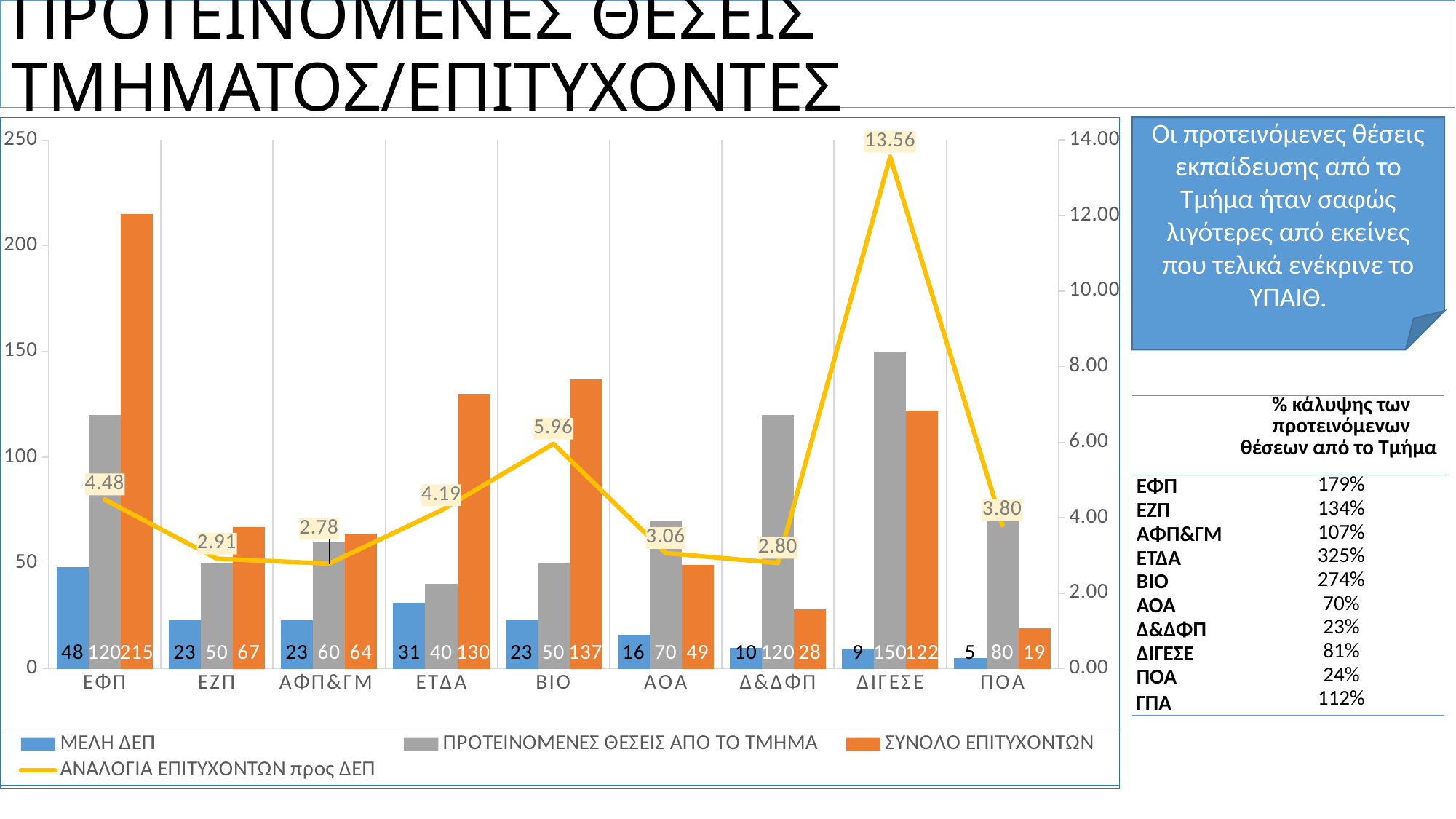
What is the value of ΑΝΑΛΟΓΙΑ ΕΠΙΤΥΧΟΝΤΩΝ προς ΔΕΠ for ΒΙΟ? 5.96 What is the value of ΜΕΛΗ ΔΕΠ for ΕΤΔΑ? 31 What is the value of ΠΡΟΤΕΙΝΟΜΕΝΕΣ ΘΕΣΕΙΣ ΑΠΟ ΤΟ ΤΜΗΜΑ for ΔΙΓΕΣΕ? 150 Which category has the highest value for ΑΝΑΛΟΓΙΑ ΕΠΙΤΥΧΟΝΤΩΝ προς ΔΕΠ? ΔΙΓΕΣΕ What is the difference between ΣΥΝΟΛΟ ΕΠΙΤΥΧΟΝΤΩΝ and ΠΡΟΤΕΙΝΟΜΕΝΕΣ ΘΕΣΕΙΣ ΑΠΟ ΤΟ ΤΜΗΜΑ for ΕΤΔΑ? 90 How many categories are shown on the x axis of the chart? 9 Which category has the lowest value for ΜΕΛΗ ΔΕΠ? ΠΟΑ How many series does the chart legend list? 4 Which is larger for ΑΟΑ: ΠΡΟΤΕΙΝΟΜΕΝΕΣ ΘΕΣΕΙΣ ΑΠΟ ΤΟ ΤΜΗΜΑ or ΣΥΝΟΛΟ ΕΠΙΤΥΧΟΝΤΩΝ? ΠΡΟΤΕΙΝΟΜΕΝΕΣ ΘΕΣΕΙΣ ΑΠΟ ΤΟ ΤΜΗΜΑ What kind of chart is shown on the slide? Combined bar and line chart Is the value of ΣΥΝΟΛΟ ΕΠΙΤΥΧΟΝΤΩΝ for ΕΦΠ greater or less than 200? greater What is the value of ΣΥΝΟΛΟ ΕΠΙΤΥΧΟΝΤΩΝ for ΕΦΠ? 215